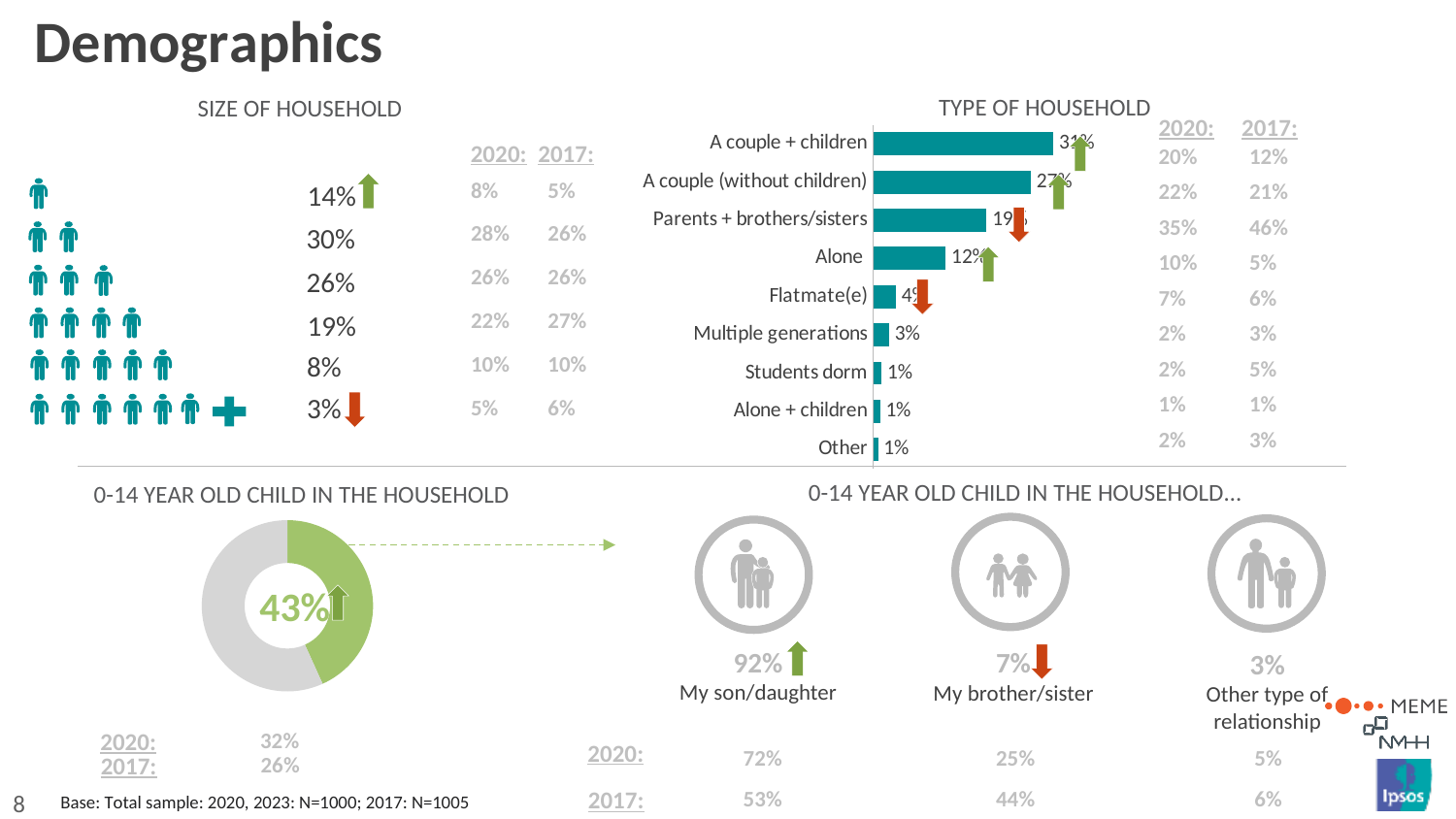
In the TYPE OF HOUSEHOLD chart, what is the difference between the values for Alone and Multiple generations? 9 percentage points In the TYPE OF HOUSEHOLD chart, which is larger: Alone or Multiple generations? Alone What kind of chart is the TYPE OF HOUSEHOLD chart? bar chart In the TYPE OF HOUSEHOLD chart, what is the value for Other? 1% What kind of chart is used for 0-14 YEAR OLD CHILD IN THE HOUSEHOLD on the lower left? donut (pie) chart In the TYPE OF HOUSEHOLD chart, do the bar values increase or decrease going from the top category to the bottom category? decrease In the TYPE OF HOUSEHOLD chart, what is the value for Students dorm? 1% In the 0-14 YEAR OLD CHILD IN THE HOUSEHOLD donut chart, what share is shown by the green slice? 43% In the TYPE OF HOUSEHOLD chart, how many household types are listed? 9 In the TYPE OF HOUSEHOLD chart, what is the value for Alone? 12% In the TYPE OF HOUSEHOLD chart, which household type has the highest value? A couple + children In the TYPE OF HOUSEHOLD chart, what is the value for Multiple generations? 3%